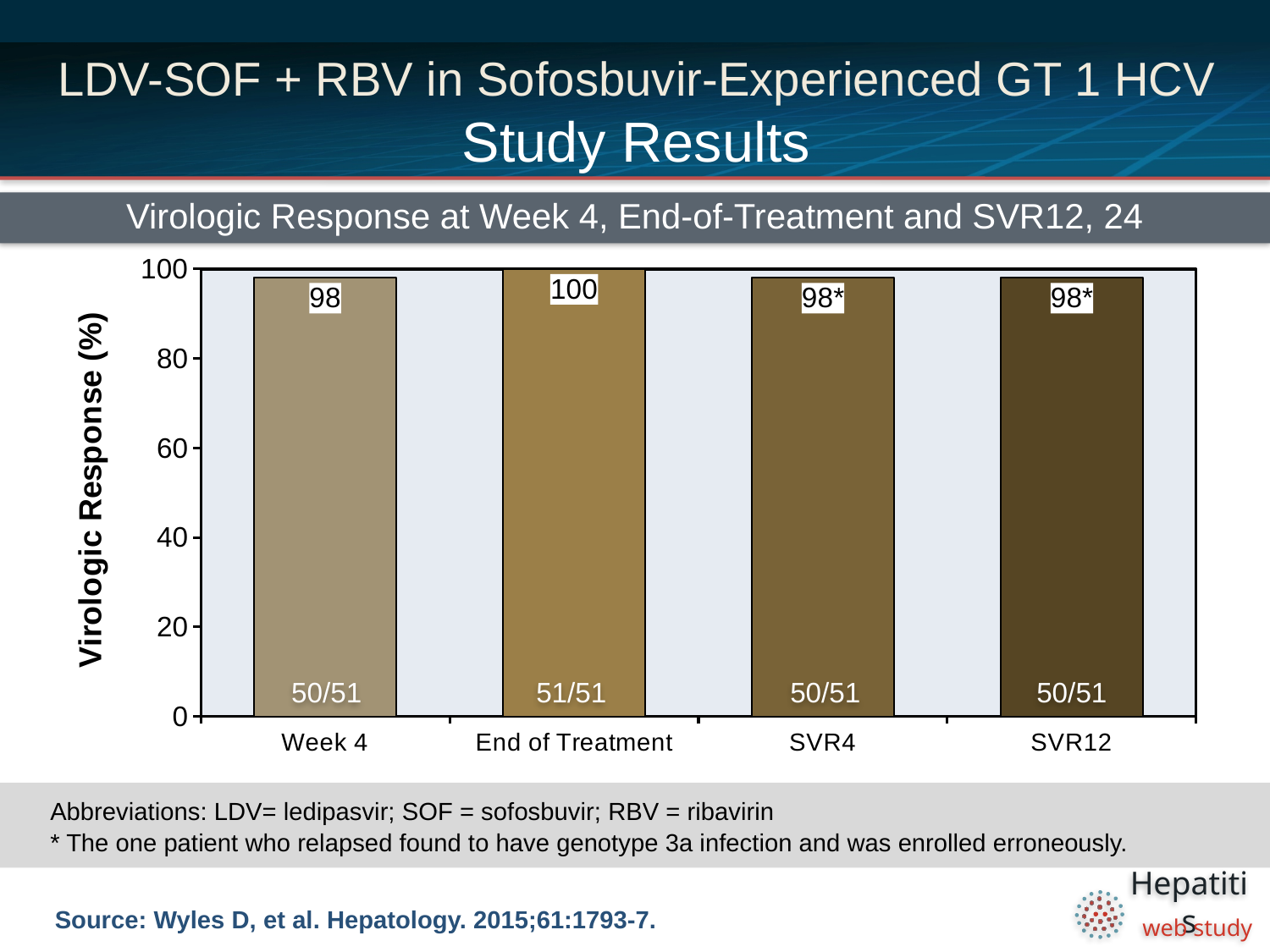
What is the virologic response value for End of Treatment? 100 What is the virologic response value for Week 4? 98 Which is larger, the value for End of Treatment or the value for SVR12? End of Treatment How many categories are shown on the x axis? 4 What is the label of the y axis? Virologic Response (%) What kind of chart is shown on the slide? Bar chart What fraction of patients is shown inside the SVR4 bar? 50/51 What is the virologic response value for SVR12? 98* Which category has the highest virologic response? End of Treatment What is the difference between the End of Treatment value and the Week 4 value? 2 What is the title shown above the chart? Virologic Response at Week 4, End-of-Treatment and SVR12, 24 What fraction of patients is shown inside the End of Treatment bar? 51/51